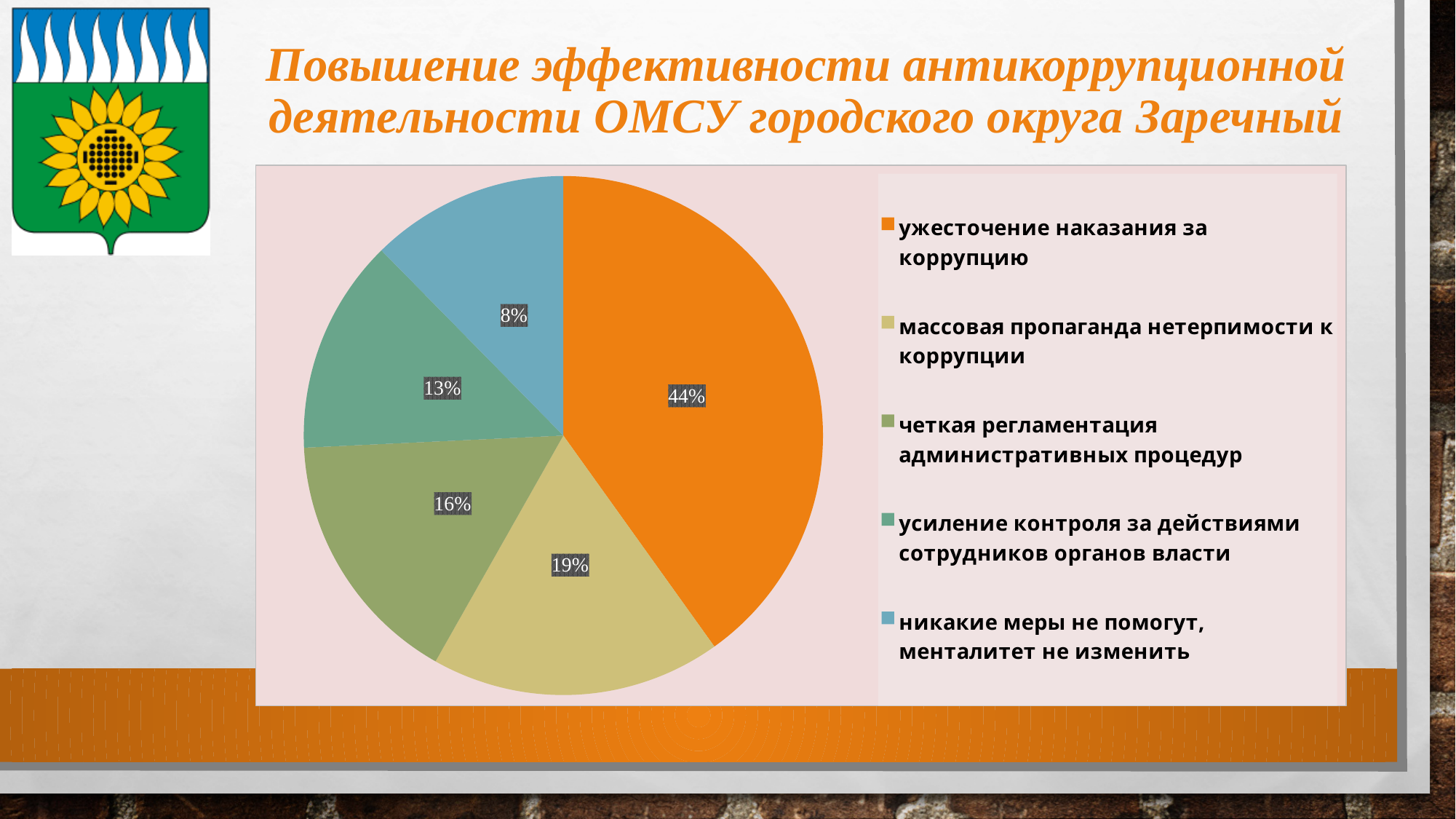
What kind of chart is shown on the slide? pie chart What share of the pie is labelled for 'массовая пропаганда нетерпимости к коррупции'? 19% How many slices does the pie chart have? 5 What share of the pie is labelled for 'никакие меры не помогут, менталитет не изменить'? 8% What is the difference in percentage points between the slice for 'ужесточение наказания за коррупцию' and the slice for 'массовая пропаганда нетерпимости к коррупции'? 25 Which category has the largest slice of the pie? ужесточение наказания за коррупцию What share of the pie is labelled for 'четкая регламентация административных процедур'? 16% Which is larger: the slice for 'четкая регламентация административных процедур' or the slice for 'усиление контроля за действиями сотрудников органов власти'? четкая регламентация административных процедур What share of the pie is labelled for 'ужесточение наказания за коррупцию'? 44% What share of the pie is labelled for 'усиление контроля за действиями сотрудников органов власти'? 13% What colour is the slice for 'никакие меры не помогут, менталитет не изменить'? blue Which category has the smallest slice of the pie? никакие меры не помогут, менталитет не изменить